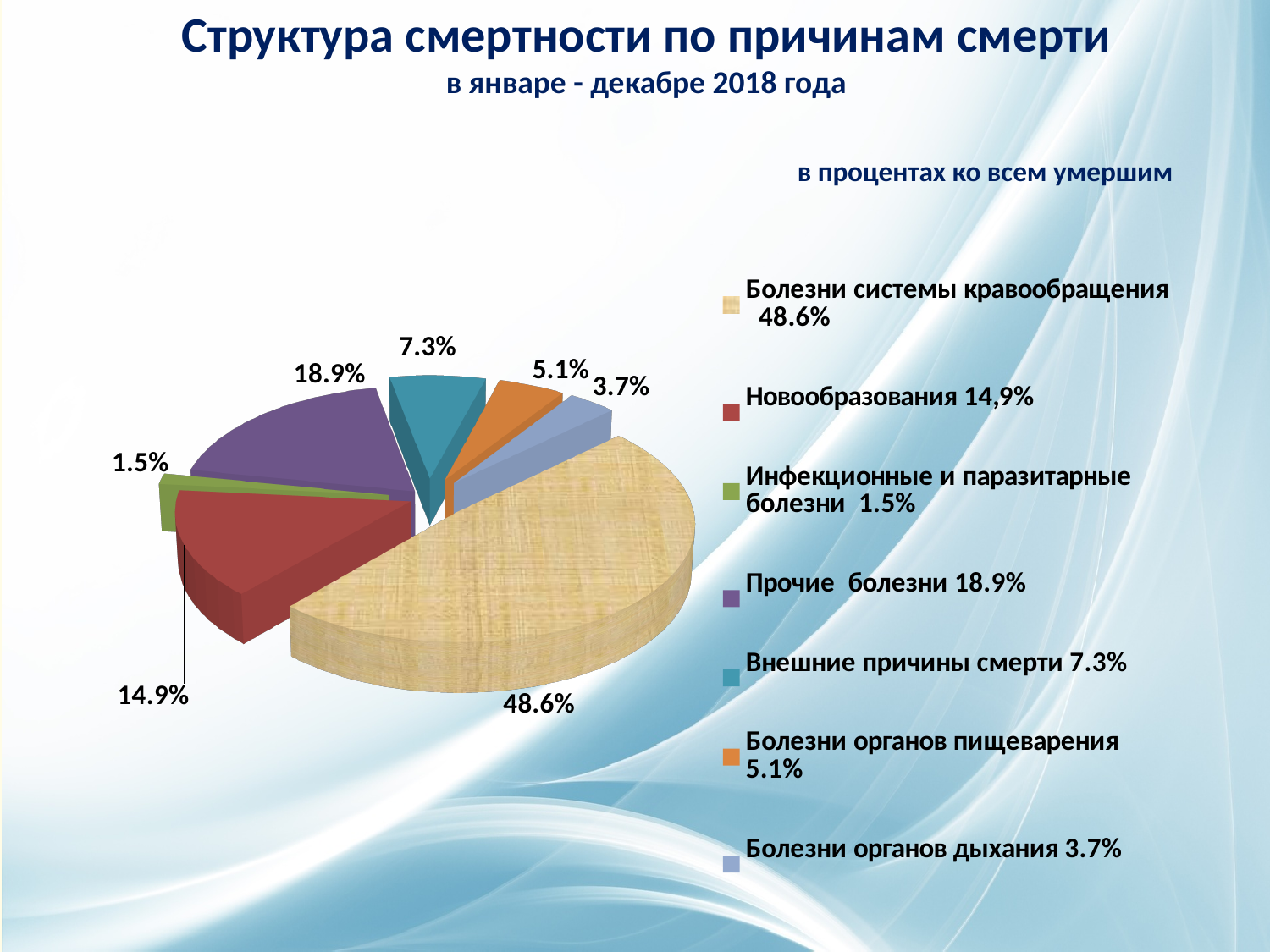
What kind of chart is shown on the slide? Pie chart What share of all deaths is attributed to Болезни органов дыхания? 3.7% What share of all deaths is attributed to Болезни системы кровообращения? 48.6% What share of all deaths is attributed to Инфекционные и паразитарные болезни? 1.5% Which cause of death has the smallest share of the pie? Инфекционные и паразитарные болезни How many slices does the pie chart have? 7 What share of all deaths is attributed to Внешние причины смерти? 7.3% What is the difference in percentage points between Прочие болезни and Новообразования? 4 percentage points Which cause of death has the largest share of the pie? Болезни системы кровообращения What share of all deaths is attributed to Новообразования? 14.9% What is the title of the chart on the slide? Структура смертности по причинам смерти в январе - декабре 2018 года Which is larger: the share for Болезни органов пищеварения or the share for Болезни органов дыхания? Болезни органов пищеварения